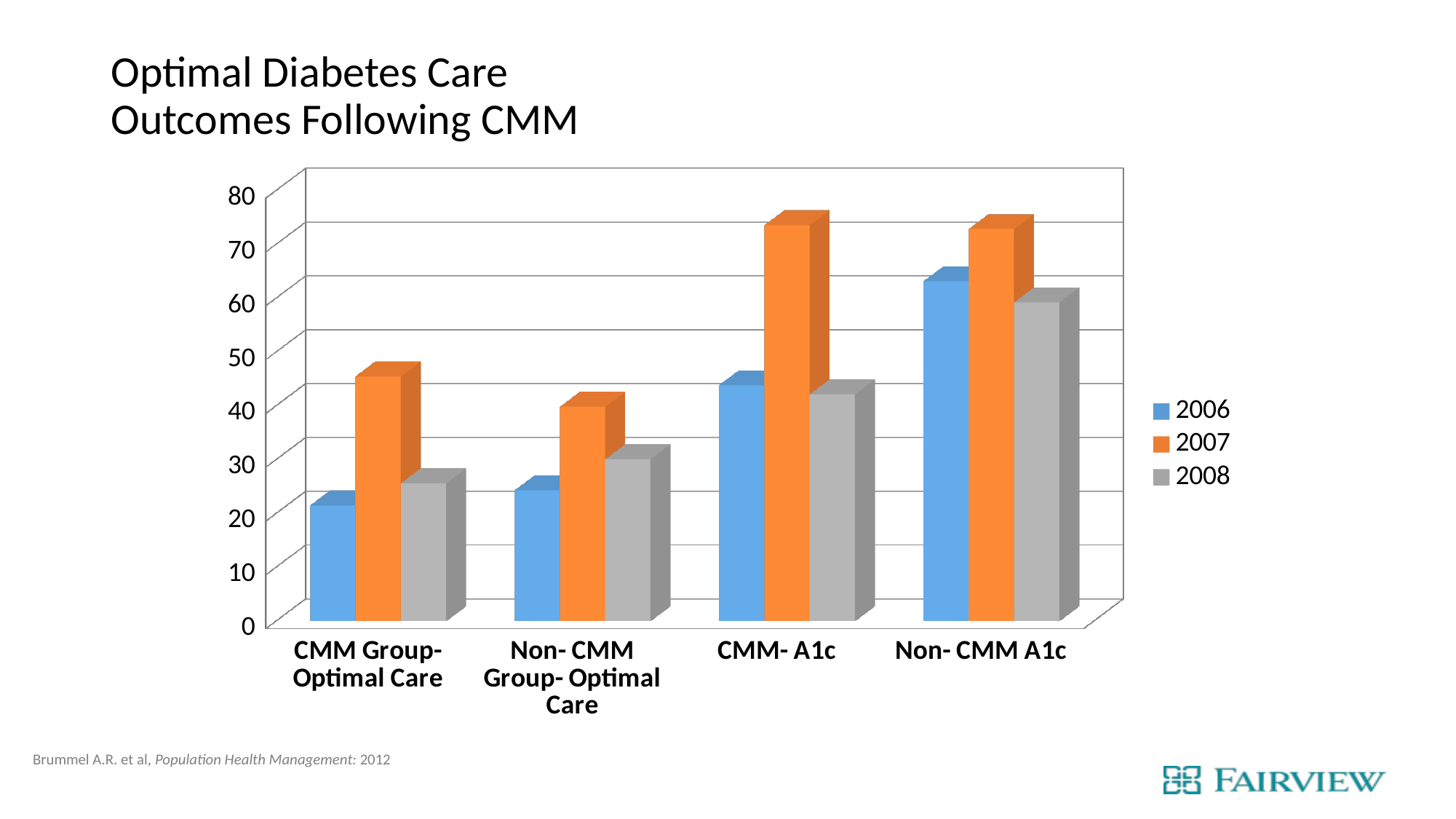
Is the 2007 value for CMM-A1c greater or less than 60? greater For CMM Group-Optimal Care, which year has the highest value? 2007 What is the title of the slide containing the chart? Optimal Diabetes Care Outcomes Following CMM Is the 2006 value for Non-CMM A1c greater or less than 50? greater Which category has the highest 2006 value? Non-CMM A1c How many categories are shown on the x axis of the chart? 4 What kind of chart is shown on the slide? Bar chart Is the 2007 value for CMM Group-Optimal Care greater or less than 40? greater How many series does the chart's legend list? 3 What are the series listed in the chart's legend? 2006, 2007, 2008 Which is larger: the 2007 value for CMM-A1c or the 2007 value for Non-CMM Group-Optimal Care? CMM-A1c